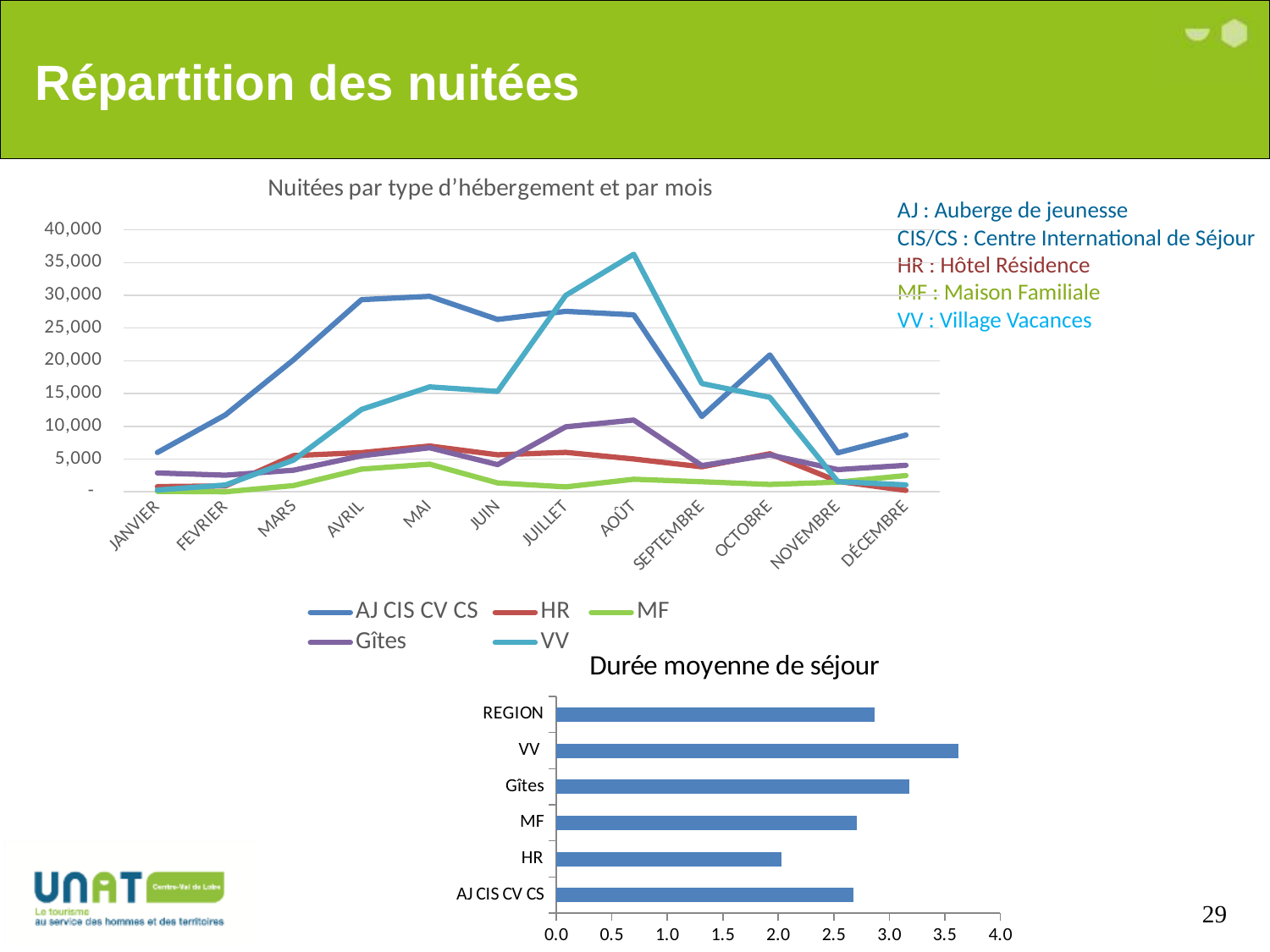
In the top chart 'Nuitées par type d'hébergement et par mois', is the value for VV in AOÛT greater or less than 30,000? greater What type of chart is the top chart titled 'Nuitées par type d'hébergement et par mois'? line chart In the top chart 'Nuitées par type d'hébergement et par mois', in which month does the VV series reach its highest value? AOÛT In the top chart 'Nuitées par type d'hébergement et par mois', how many series does the legend list? 5 In the top chart 'Nuitées par type d'hébergement et par mois', do the values for AJ CIS CV CS rise or fall from JANVIER to AVRIL? rise In the bottom chart 'Durée moyenne de séjour', is the value for HR greater or less than 2.5? less In the bottom chart 'Durée moyenne de séjour', which is larger, the value for Gîtes or the value for MF? Gîtes In the top chart 'Nuitées par type d'hébergement et par mois', is the value for AJ CIS CV CS in SEPTEMBRE greater or less than 10,000? greater What type of chart is the bottom chart titled 'Durée moyenne de séjour'? bar chart In the bottom chart 'Durée moyenne de séjour', which category has the lowest value? HR In the bottom chart 'Durée moyenne de séjour', which category has the highest value? VV In the top chart 'Nuitées par type d'hébergement et par mois', how many months are shown on the x axis? 12